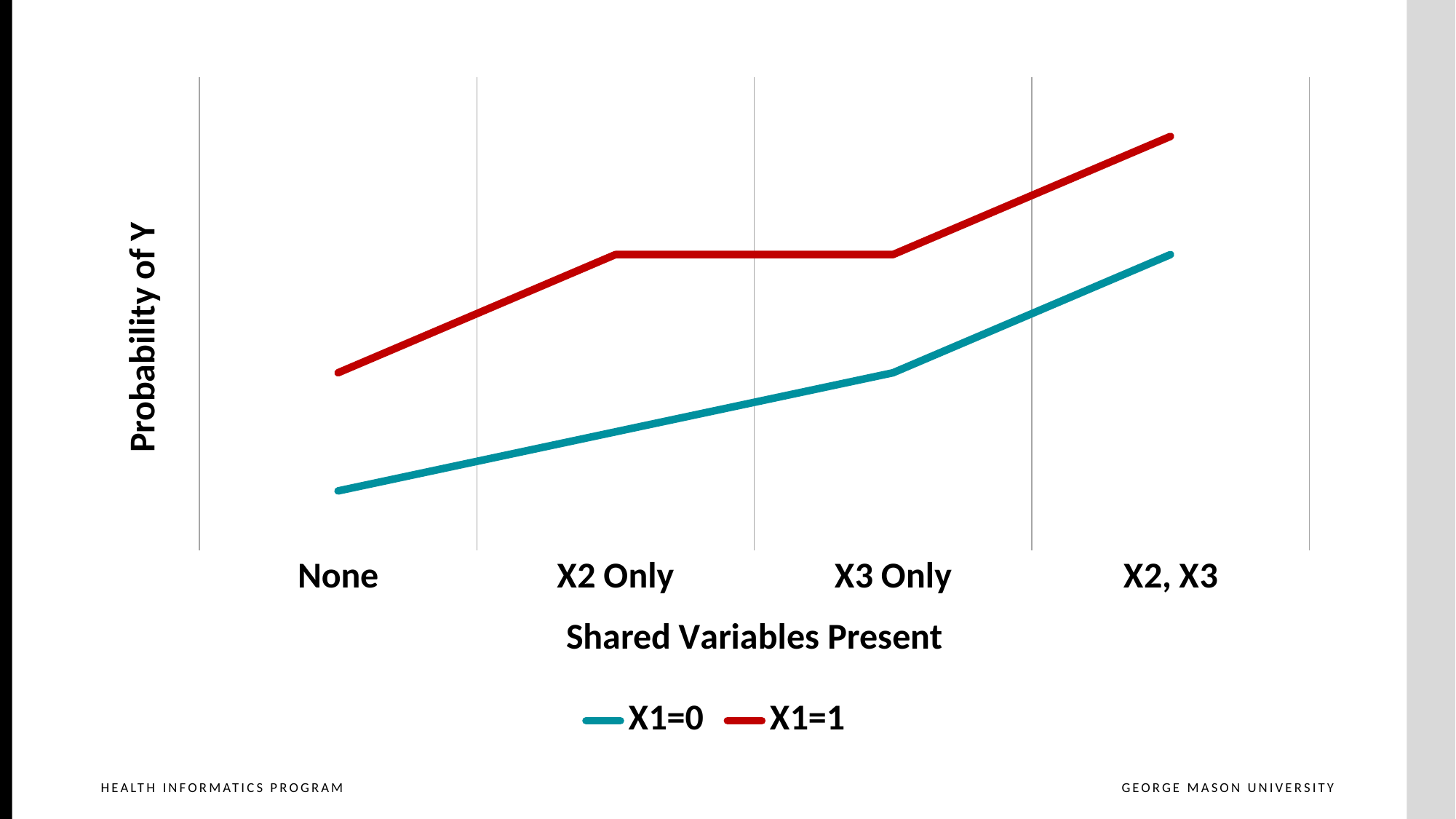
For the X1=0 series, which category has the highest probability of Y? X2, X3 For the X1=1 series, which category has the highest probability of Y? X2, X3 What kind of chart is shown on the slide? Line chart For the X1=1 series, which category has the lowest probability of Y? None Does the X1=0 line rise or fall from None to X2, X3? Rise How many categories are shown along the x axis? 4 At the None category, which series has the higher probability of Y, X1=0 or X1=1? X1=1 What is the title of the x axis? Shared Variables Present What is the title of the y axis? Probability of Y For the X1=0 series, which category has the lowest probability of Y? None Between X2 Only and X3 Only, does the X1=1 line rise, fall, or stay flat? Stay flat How many series does the legend list? 2